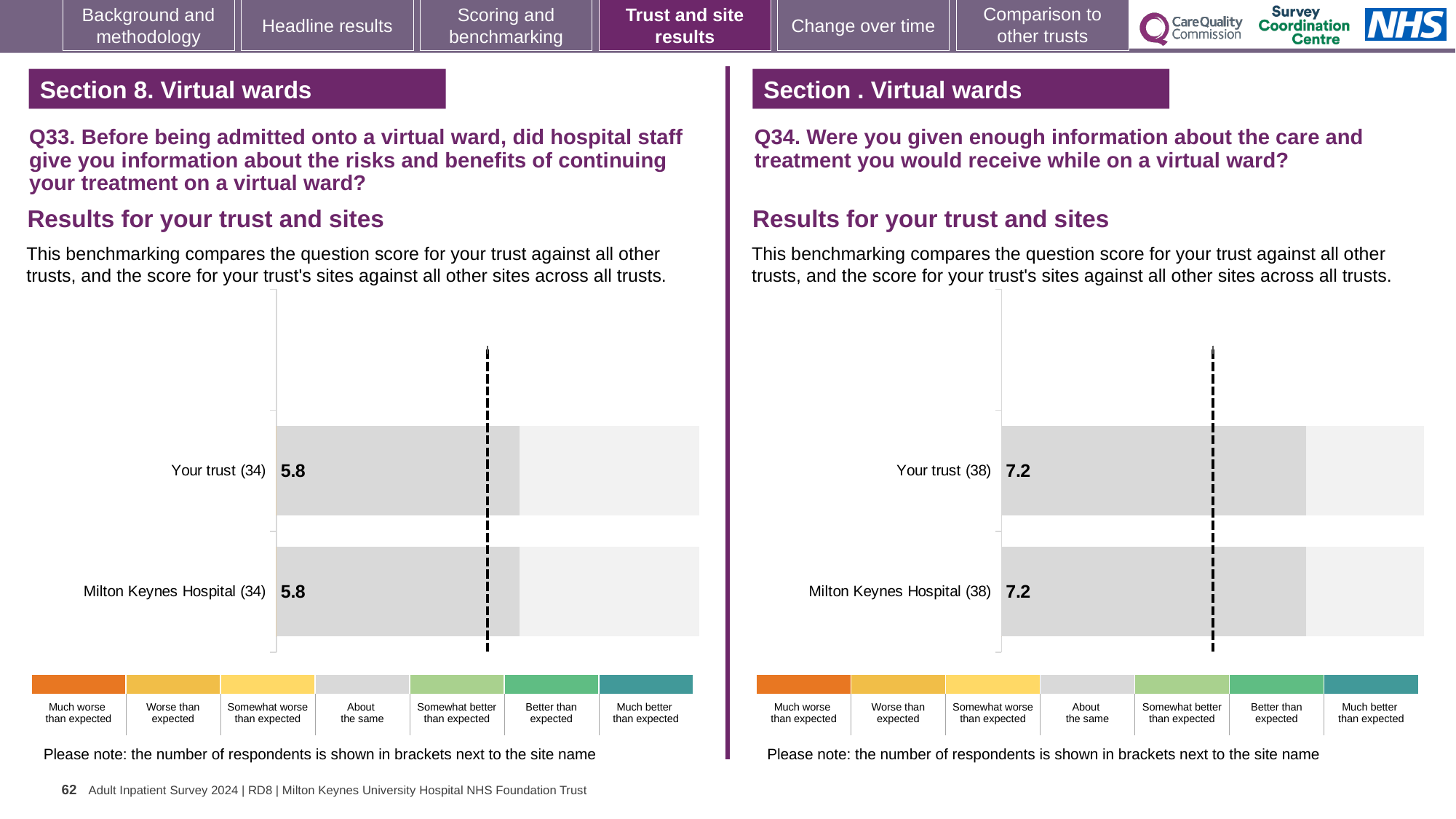
In the Q33 chart on the left, what is the score for Your trust? 5.8 What kind of chart is used for the Q34 results on the right? Bar chart In the Q34 chart on the right, how many respondents are shown in brackets for Milton Keynes Hospital? 38 How many categories (rows) are plotted in the Q33 chart on the left? 2 In the Q34 chart on the right, what is the score for Milton Keynes Hospital? 7.2 In the Q33 chart on the left, what is the difference between the score for Your trust and the score for Milton Keynes Hospital? 0 In the Q33 chart on the left, which benchmark band does the score for Your trust fall into? About the same In the Q33 chart on the left, what is the score for Milton Keynes Hospital? 5.8 In the Q33 chart on the left, how many respondents are shown in brackets for Your trust? 34 In the Q34 chart on the right, what is the score for Your trust? 7.2 In the Q34 chart on the right, what is the difference between the score for Your trust and the score for Milton Keynes Hospital? 0 How many benchmark bands are shown in the colour key below the Q34 chart on the right? 7